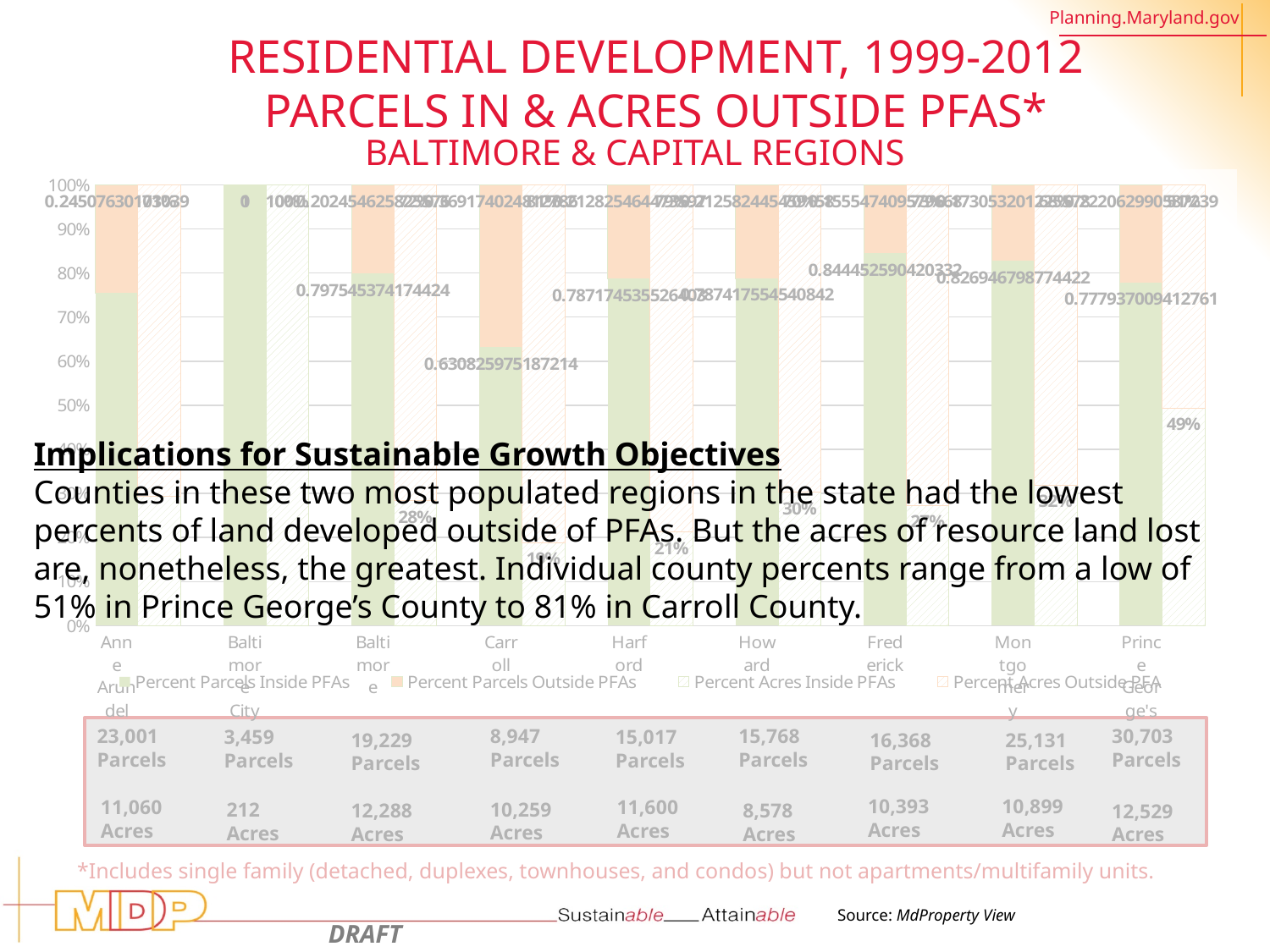
What is the first series listed in the chart legend? Percent Parcels Inside PFAs What value is labelled on the Frederick bar at the top of its green segment? 0.844452590420332 What value is labelled on the Carroll bar at the top of its green segment? 0.630825975187214 What value is labelled on the Prince George's bar at the top of its green segment? 0.777937009412761 Is the green segment for Carroll greater or less than 70%? less Which is larger, the green segment for Carroll or the green segment for Frederick? Frederick What kind of chart is shown on the slide? stacked bar chart How many series does the chart legend list? 4 Is the green segment for Frederick greater or less than 80%? greater How many counties (categories) are plotted along the x axis of the chart? 9 Which county has the lowest green (Percent Parcels Inside PFAs) segment in the chart? Carroll What is the last series listed in the chart legend? Percent Acres Outside PFA